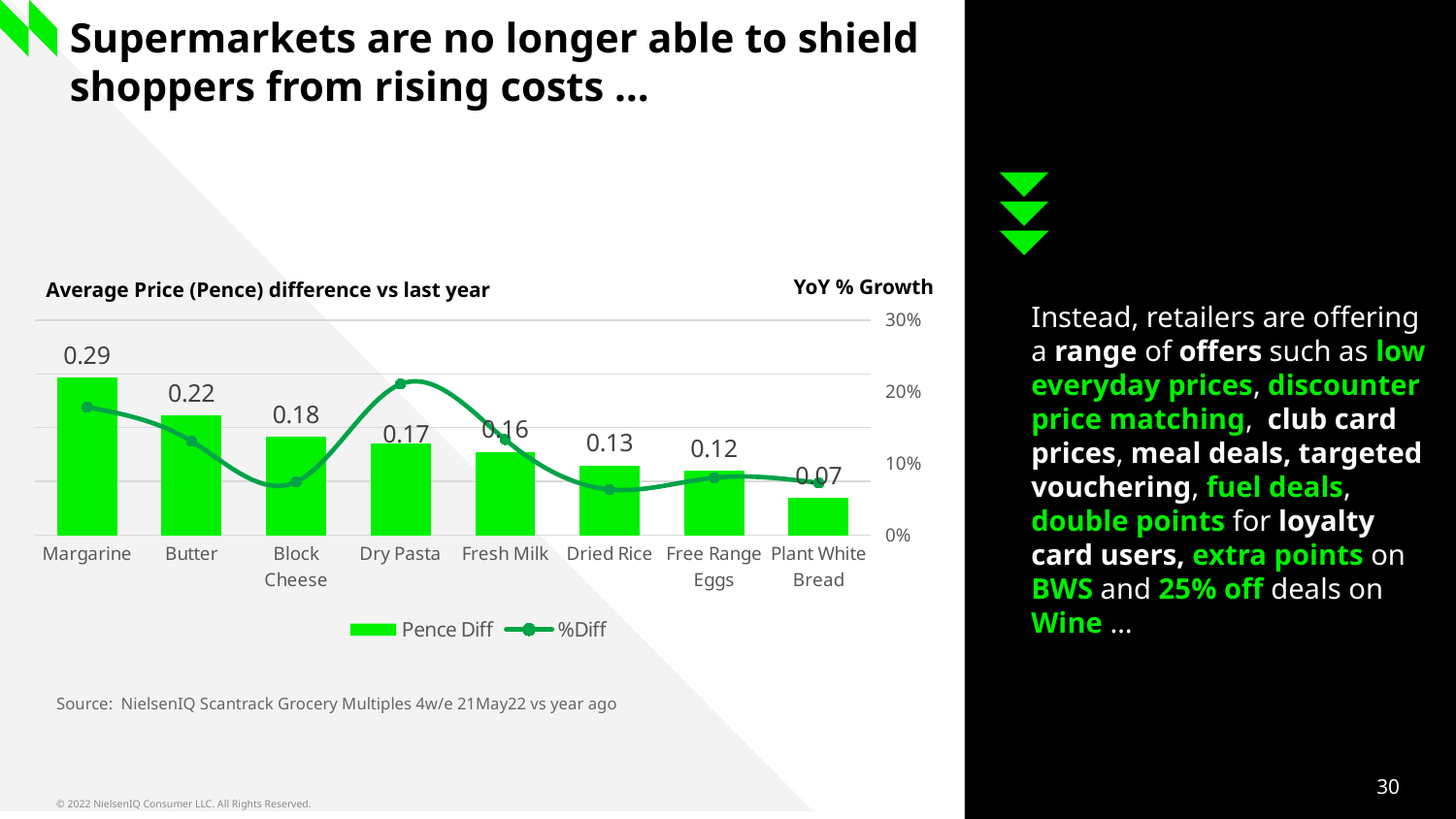
What is the difference in Pence Diff between Butter and Dried Rice? 0.09 Is the %Diff value for Block Cheese greater or less than 10%? less Which has a larger Pence Diff, Block Cheese or Fresh Milk? Block Cheese Do the Pence Diff bar values rise or fall from left to right along the x axis? fall How many categories are shown on the x axis? 8 Which category has the highest Pence Diff? Margarine Is the %Diff value for Dry Pasta greater or less than 20%? greater How many series does the legend list? 2 Which category has the lowest Pence Diff? Plant White Bread What is the Pence Diff value for Margarine? 0.29 What is the title of the chart? Average Price (Pence) difference vs last year What is the Pence Diff value for Free Range Eggs? 0.12